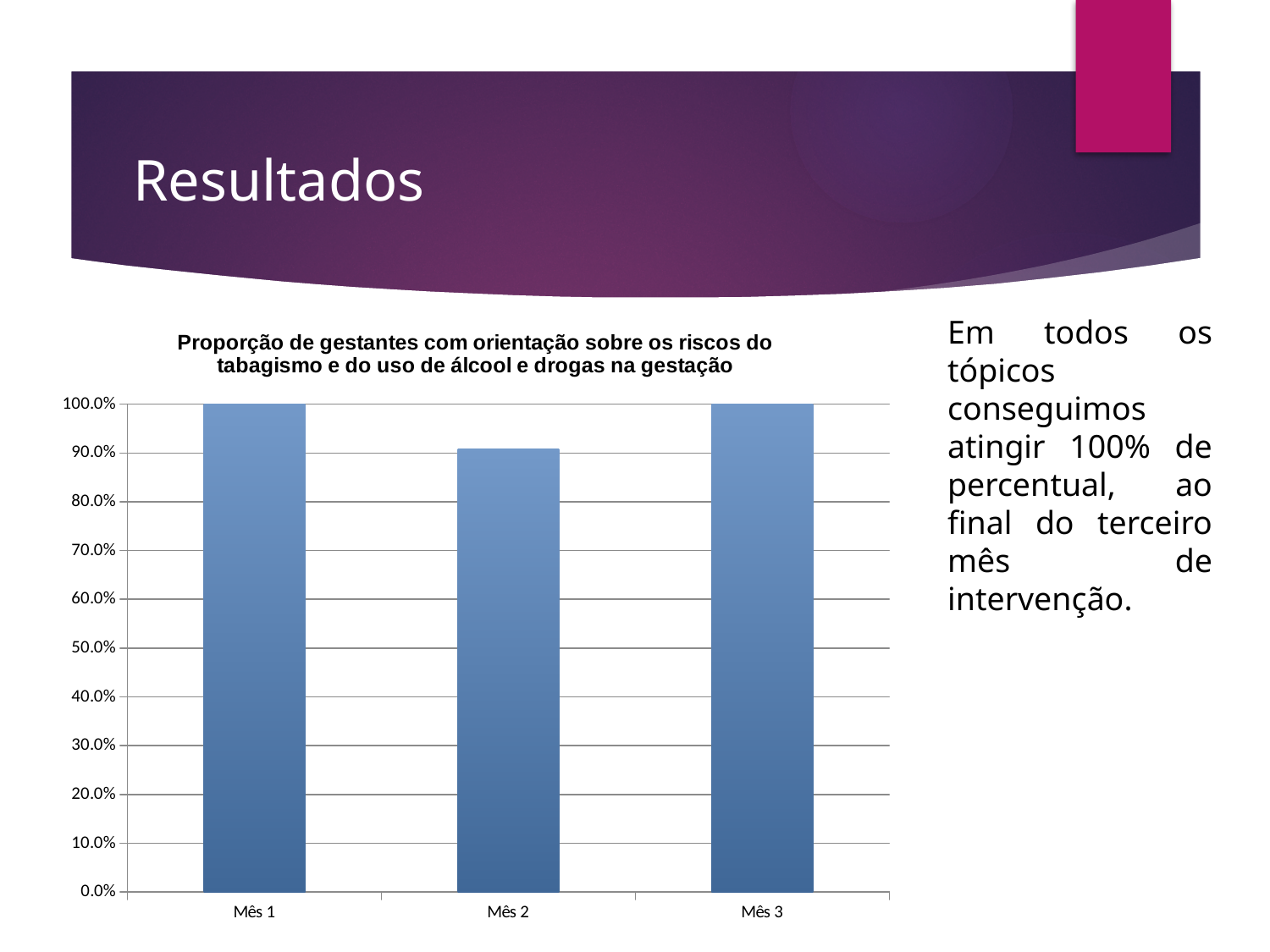
What type of chart is shown on the slide? bar chart Is the value for Mês 2 greater or less than 80.0%? greater How many categories (months) are shown on the x axis of the chart? 3 What is the value for Mês 1? 100.0% What is the value for Mês 3? 100.0% Does the value rise or fall from Mês 1 to Mês 2? fall Is the value for Mês 2 greater or less than 100.0%? less What is the title of the chart? Proporção de gestantes com orientação sobre os riscos do tabagismo e do uso de álcool e drogas na gestação Which is larger, the value for Mês 1 or the value for Mês 2? Mês 1 Which month has the lowest value? Mês 2 Does the value rise or fall from Mês 2 to Mês 3? rise Which is larger, the value for Mês 2 or the value for Mês 3? Mês 3